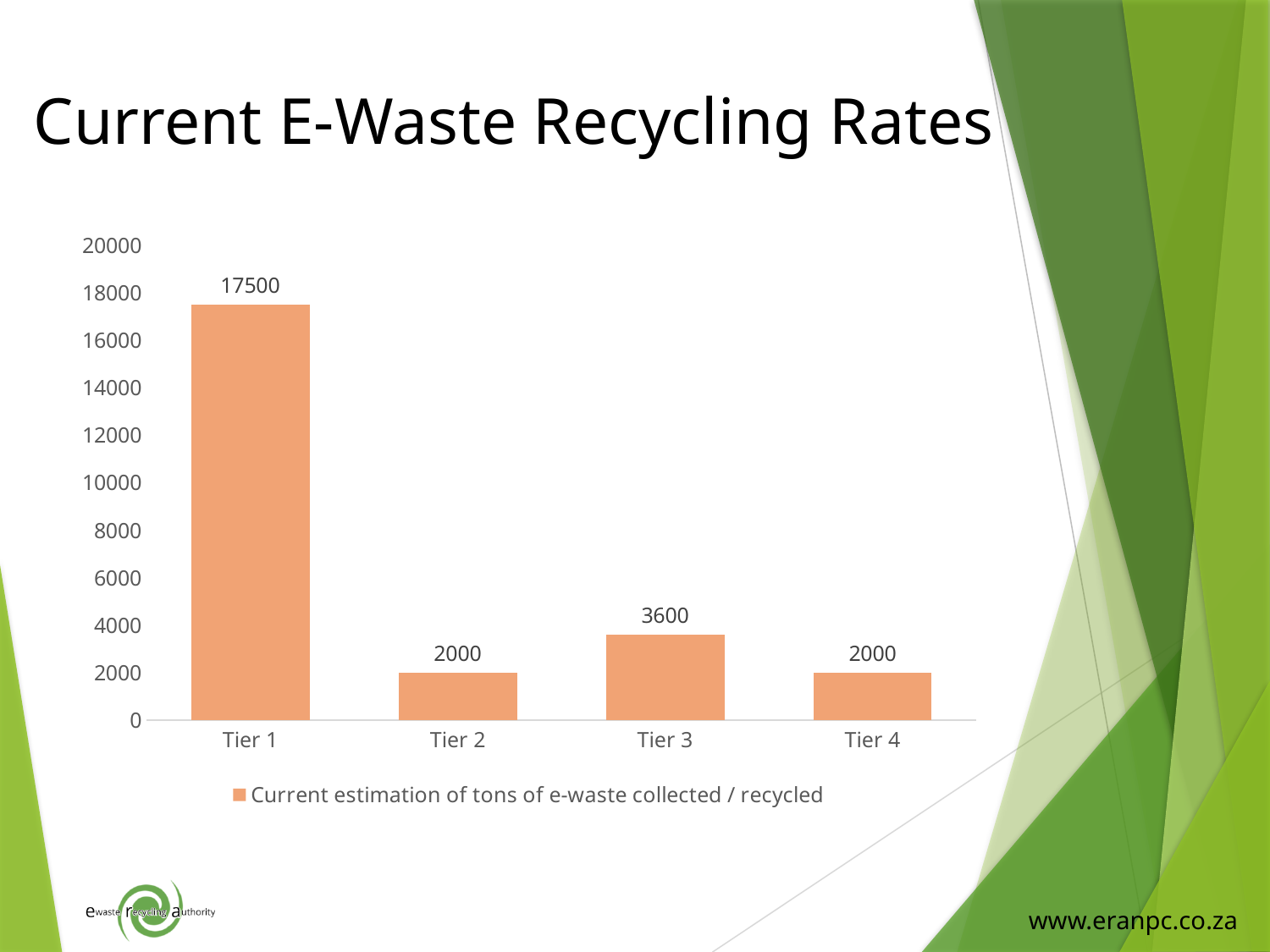
What kind of chart is shown on the slide? Bar chart What is the difference between the values for Tier 3 and Tier 4? 1600 How many tiers are shown on the x axis? 4 What is the difference between the values for Tier 1 and Tier 3? 13900 Which tier has the highest value? Tier 1 What is the value for Tier 2? 2000 How many series does the legend list? 1 Is the value for Tier 1 greater or less than 16000? greater What is the value for Tier 3? 3600 What is the legend entry for the series shown? Current estimation of tons of e-waste collected / recycled Which is larger, the value for Tier 2 or the value for Tier 3? Tier 3 What is the value for Tier 1? 17500